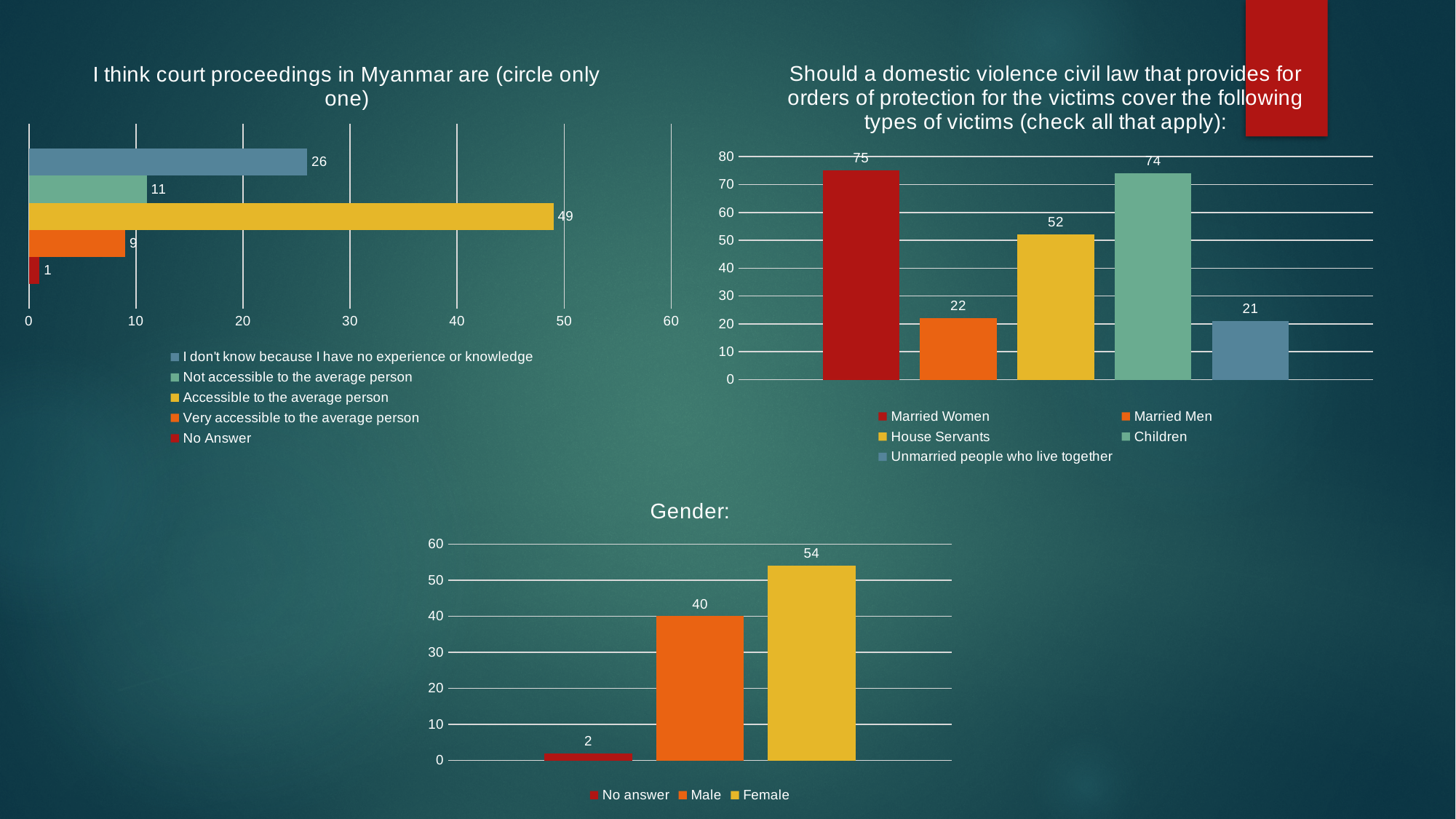
What kind of chart is the top-left chart about court proceedings in Myanmar? Bar chart In the top-right chart about the domestic violence civil law, which is larger: House Servants or Unmarried people who live together? House Servants In the top-right chart about the domestic violence civil law, which category has the highest value? Married Women In the chart titled "I think court proceedings in Myanmar are (circle only one)", what is the value for "Accessible to the average person"? 49 In the top-right chart about the domestic violence civil law, what is the value for Married Men? 22 In the chart titled "Gender:", what is the value for Female? 54 In the top-right chart about the domestic violence civil law, what is the difference between Married Women and Children? 1 In the chart titled "I think court proceedings in Myanmar are (circle only one)", which category has the lowest value? No Answer How many legend entries does the chart titled "I think court proceedings in Myanmar are (circle only one)" list? 5 In the chart titled "I think court proceedings in Myanmar are (circle only one)", what is the difference between "I don't know because I have no experience or knowledge" and "Not accessible to the average person"? 15 How many bars are shown in the chart titled "Gender:"? 3 In the chart titled "Gender:", what is the difference between Female and Male? 14